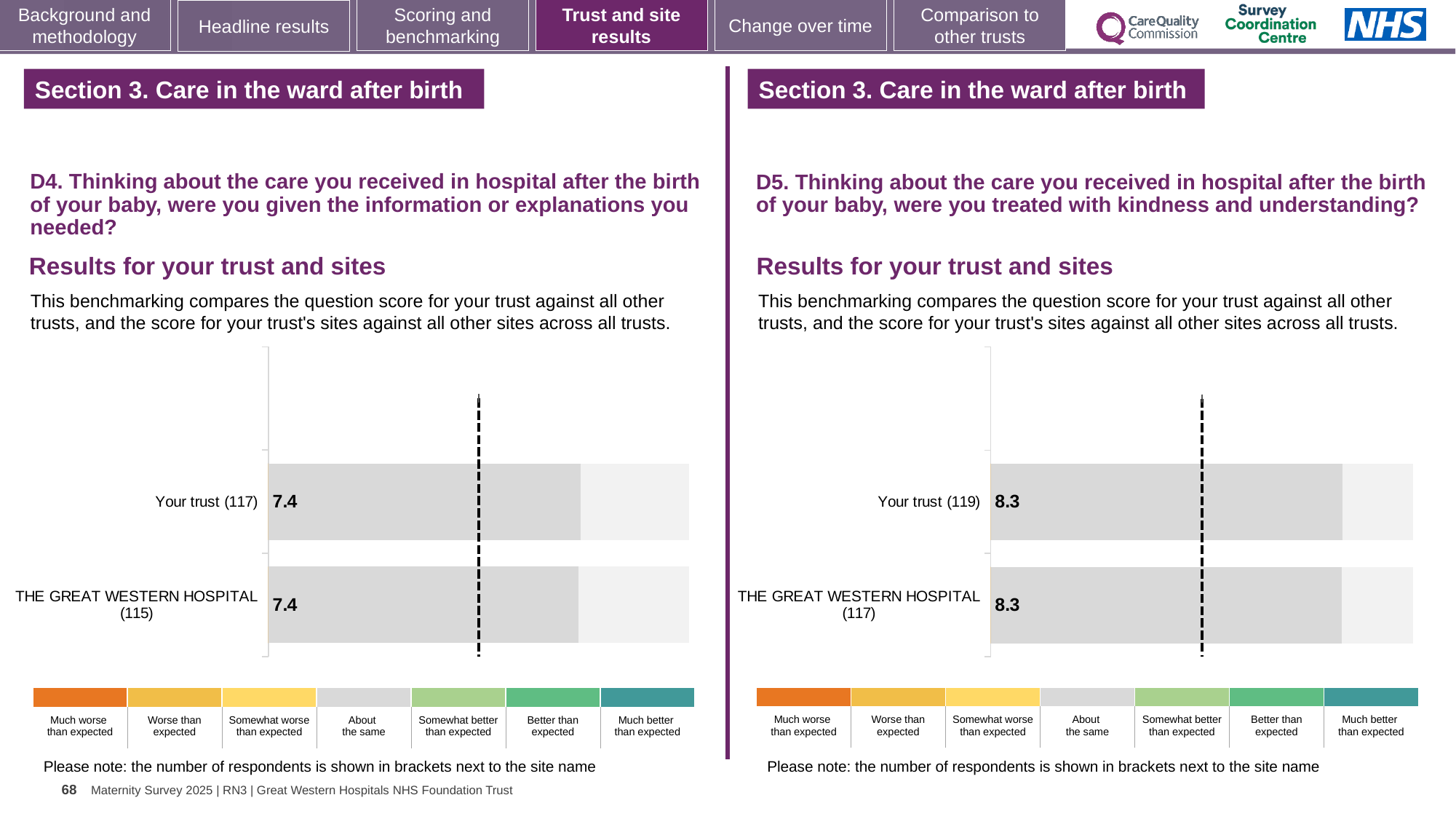
In the left chart (D4), what is the difference between the score for Your trust and the score for THE GREAT WESTERN HOSPITAL? 0.0 In the left chart (D4), how many respondents are shown in brackets for THE GREAT WESTERN HOSPITAL? 115 In the right chart (D5), how many respondents are shown in brackets for Your trust? 119 How many bars are plotted in the left chart (D4)? 2 In the right chart (D5), what is the score for Your trust? 8.3 What kind of chart is used in the left chart (D4)? Bar chart How many bars are plotted in the right chart (D5)? 2 In the left chart (D4), what is the score for THE GREAT WESTERN HOSPITAL? 7.4 In the right chart (D5), what is the score for THE GREAT WESTERN HOSPITAL? 8.3 In the left chart (D4), what is the score for Your trust? 7.4 How many categories does the colour key below the right chart (D5) list? 7 In the right chart (D5), what is the difference between the score for Your trust and the score for THE GREAT WESTERN HOSPITAL? 0.0